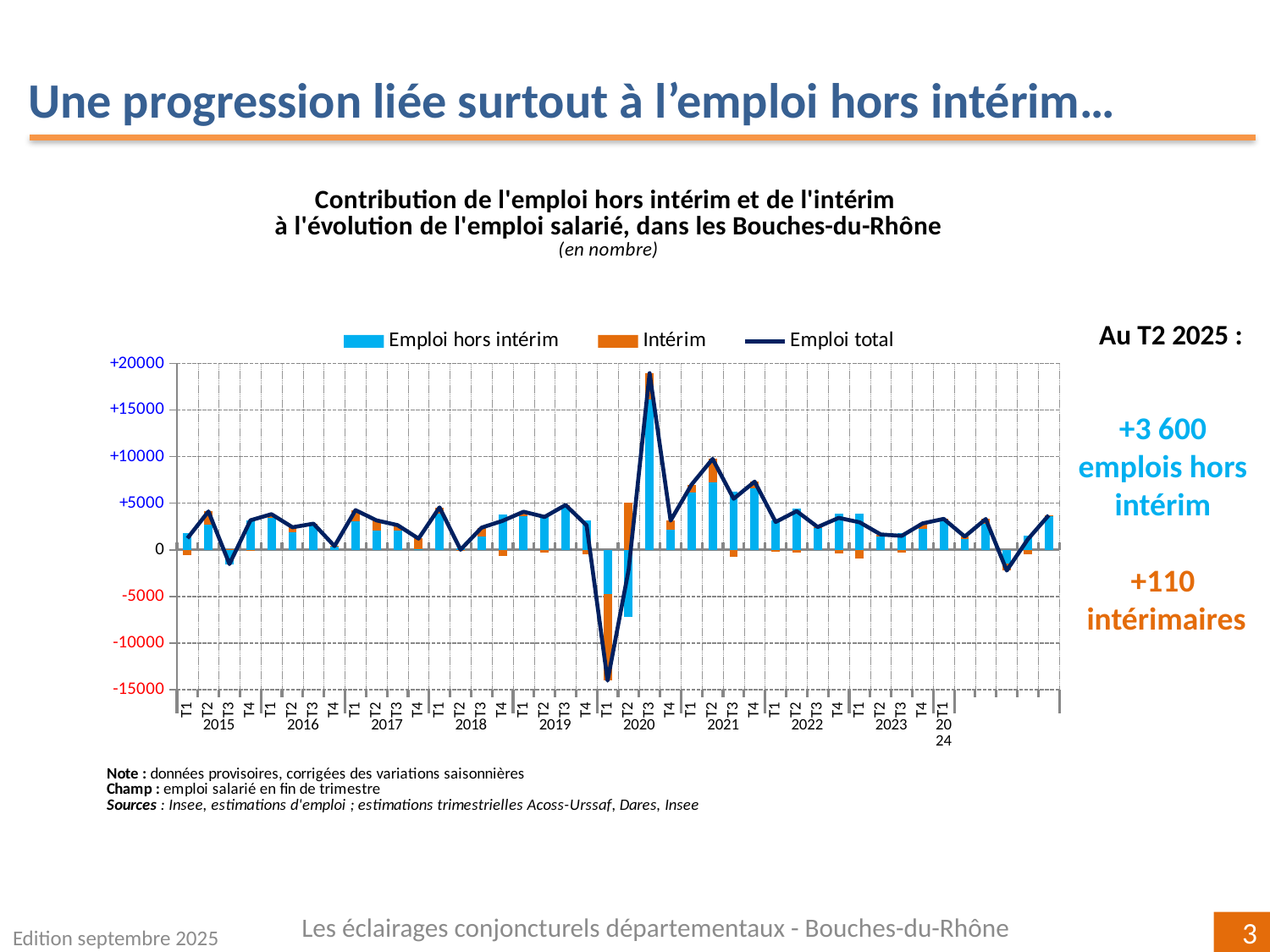
How many series does the chart legend list? 3 Is the value of Emploi total at T3 2020 greater or less than 15000? greater What kind of chart is shown on the slide? A combined bar and line chart What colour are the bars for the Intérim series? Orange According to the text beside the chart, what is the value for Emploi hors intérim at T2 2025? +3 600 Is the value of Emploi total at T2 2021 greater or less than 5000? greater According to the text beside the chart, what is the value for Intérim at T2 2025? +110 In which quarter does the Emploi total line reach its highest value? T3 2020 Is the value of Emploi total at T1 2020 greater or less than -10000? less In which quarter does the Emploi total line reach its lowest value? T1 2020 Which series is drawn as a line in the chart? Emploi total Which is larger, the Emploi total value at T3 2020 or at T2 2021? T3 2020